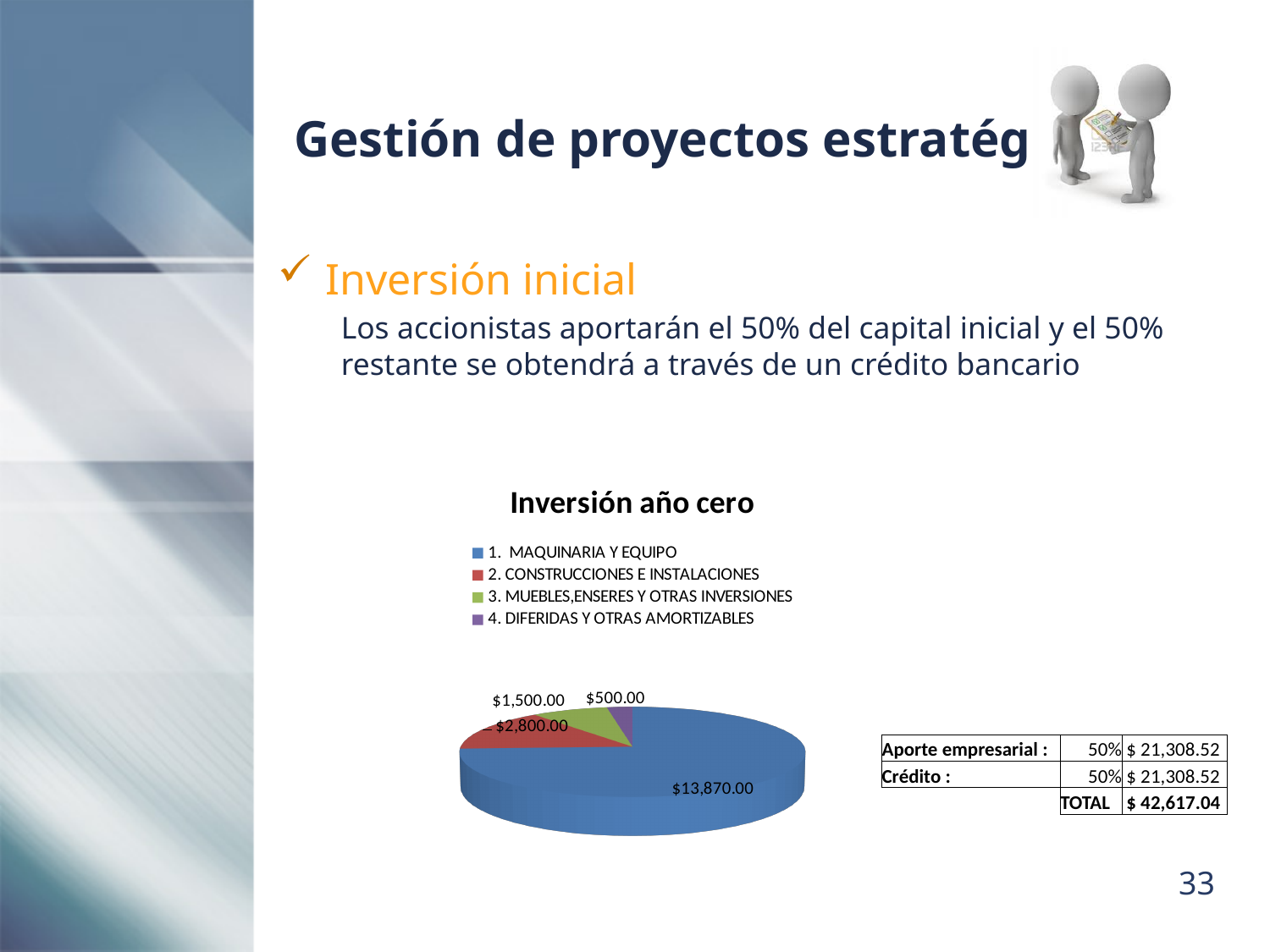
In the pie chart, which is larger: "2. CONSTRUCCIONES E INSTALACIONES" or "3. MUEBLES,ENSERES Y OTRAS INVERSIONES"? 2. CONSTRUCCIONES E INSTALACIONES Which category has the largest slice in the pie chart? 1. MAQUINARIA Y EQUIPO How many categories does the legend of the pie chart list? 4 In the pie chart, what is the value for "1. MAQUINARIA Y EQUIPO"? $13,870.00 In the pie chart, what is the difference between the value for "1. MAQUINARIA Y EQUIPO" and the value for "2. CONSTRUCCIONES E INSTALACIONES"? $11,070.00 Which category has the smallest slice in the pie chart? 4. DIFERIDAS Y OTRAS AMORTIZABLES In the pie chart, what is the value for "3. MUEBLES,ENSERES Y OTRAS INVERSIONES"? $1,500.00 What kind of chart is shown under the heading "Inversión año cero"? Pie chart What is the total of all four values shown in the pie chart? $18,670.00 In the pie chart, what is the value for "2. CONSTRUCCIONES E INSTALACIONES"? $2,800.00 What is the title of the pie chart on the slide? Inversión año cero In the pie chart, what is the value for "4. DIFERIDAS Y OTRAS AMORTIZABLES"? $500.00